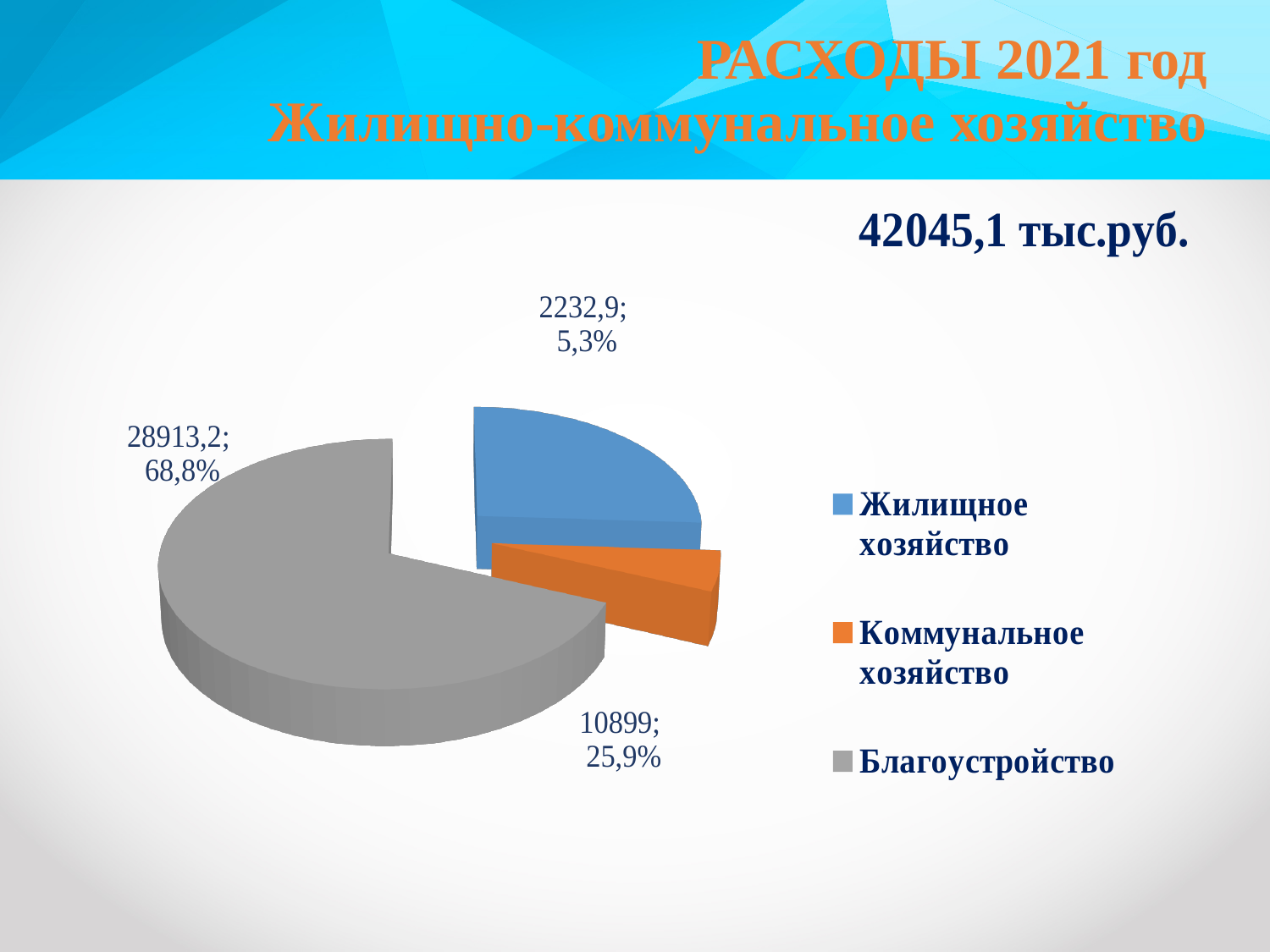
What is the smallest value labelled on the pie chart? 2232,9 What share of the pie does Благоустройство take? 68,8% What is the value shown for Благоустройство? 28913,2 What colour is the Благоустройство slice? gray What is the difference between the largest labelled value (28913,2) and the smallest labelled value (2232,9)? 26680,3 How many slices does the pie chart have? 3 What is the title of the slide above the chart? РАСХОДЫ 2021 год Жилищно-коммунальное хозяйство What kind of chart is shown on the slide? pie chart How many entries does the legend list? 3 Which category has the largest share of the pie? Благоустройство Which is larger: the share for Благоустройство or the share labelled 25,9%? Благоустройство What is the total amount shown on the slide for all categories? 42045,1 тыс.руб.